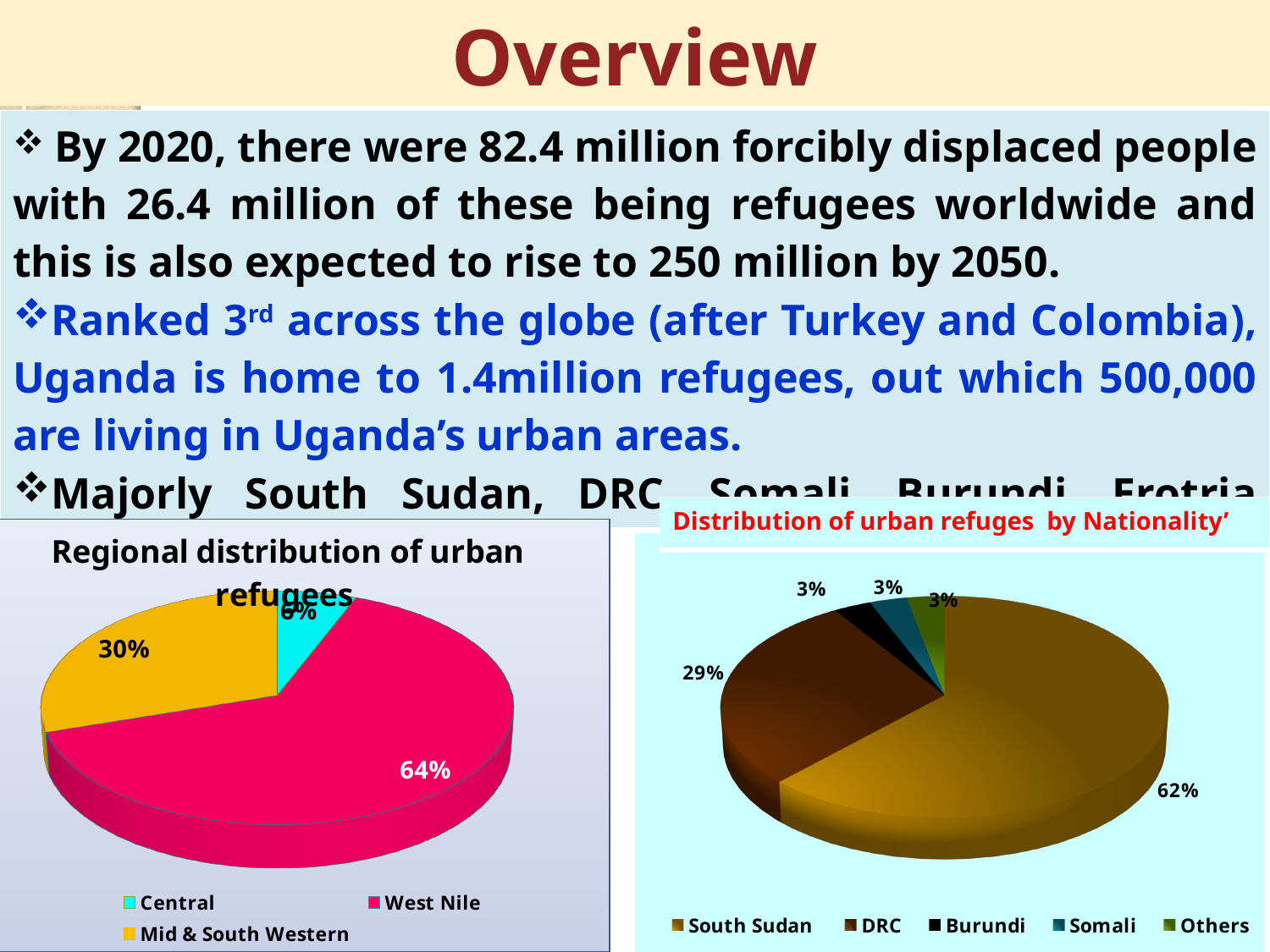
In the 'Distribution of urban refuges by Nationality' chart, which nationality has the largest share? South Sudan In the 'Regional distribution of urban refugees' chart, what share of urban refugees is in West Nile? 64% In the 'Distribution of urban refuges by Nationality' chart, what share is DRC? 29% In the 'Regional distribution of urban refugees' chart, what is the difference between the West Nile and Mid & South Western shares? 34 percentage points In the 'Distribution of urban refuges by Nationality' chart, what share is South Sudan? 62% In the 'Regional distribution of urban refugees' chart, how many regions are shown in the legend? 3 In the 'Distribution of urban refuges by Nationality' chart, how many categories does the legend list? 5 In the 'Distribution of urban refuges by Nationality' chart, what share is Somali? 3% In the 'Regional distribution of urban refugees' chart, which region has the largest share? West Nile What type of chart is the 'Distribution of urban refuges by Nationality' chart? Pie chart In the 'Regional distribution of urban refugees' chart, which region has the smallest share? Central In the 'Regional distribution of urban refugees' chart, what share is Mid & South Western? 30%